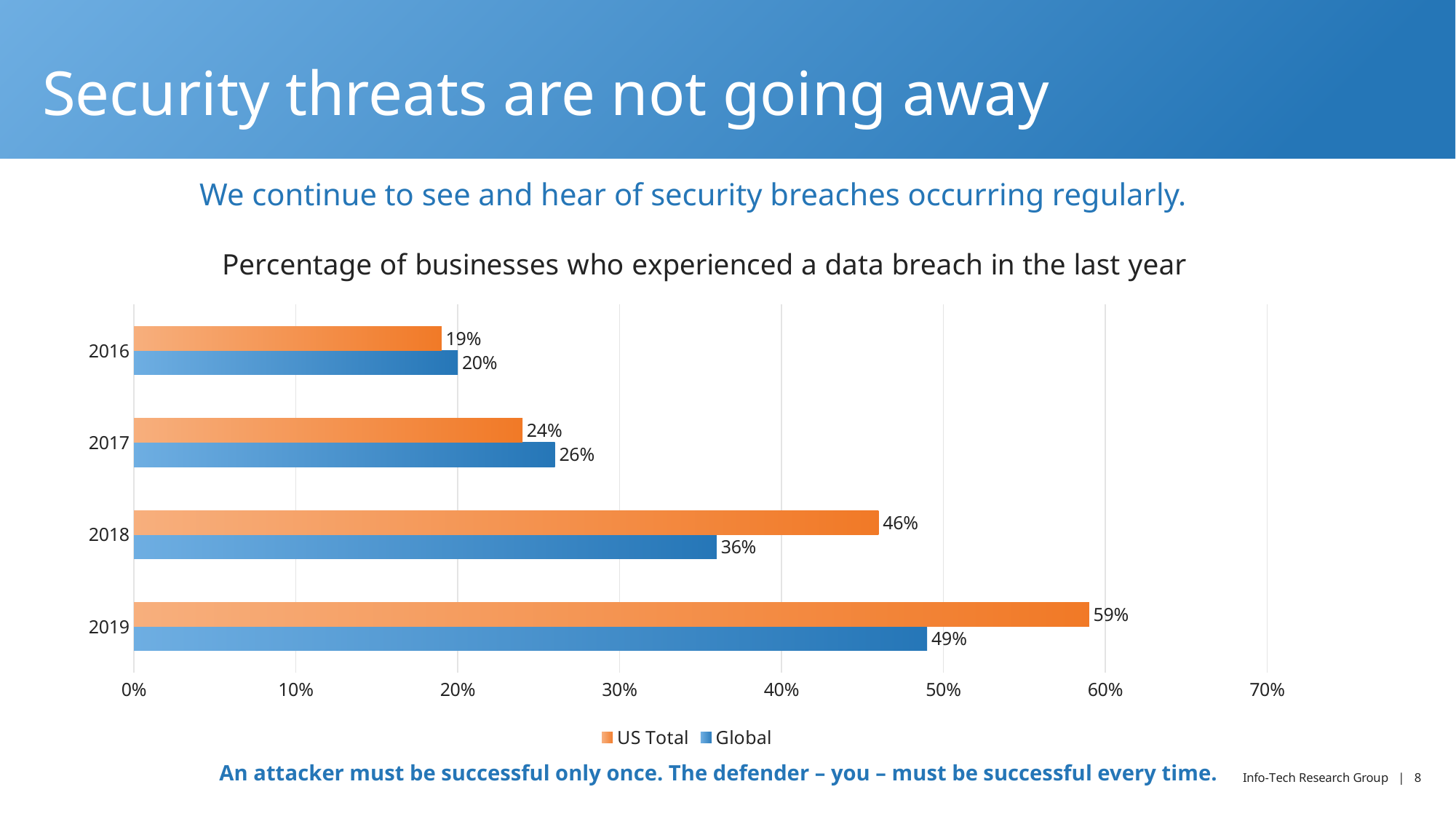
What is the title of the chart? Percentage of businesses who experienced a data breach in the last year What is the Global value for 2017? 26% What is the US Total value for 2016? 19% Which year has the lowest US Total value? 2016 Which is larger for 2017, the US Total value or the Global value? Global Which year has the highest Global value? 2019 What is the difference between the US Total and Global values for 2018? 10% Do the US Total values rise or fall from 2016 to 2019? Rise How many years are shown on the chart? 4 How many series does the legend list? 2 What kind of chart is shown on the slide? Bar chart What is the US Total value for 2019? 59%